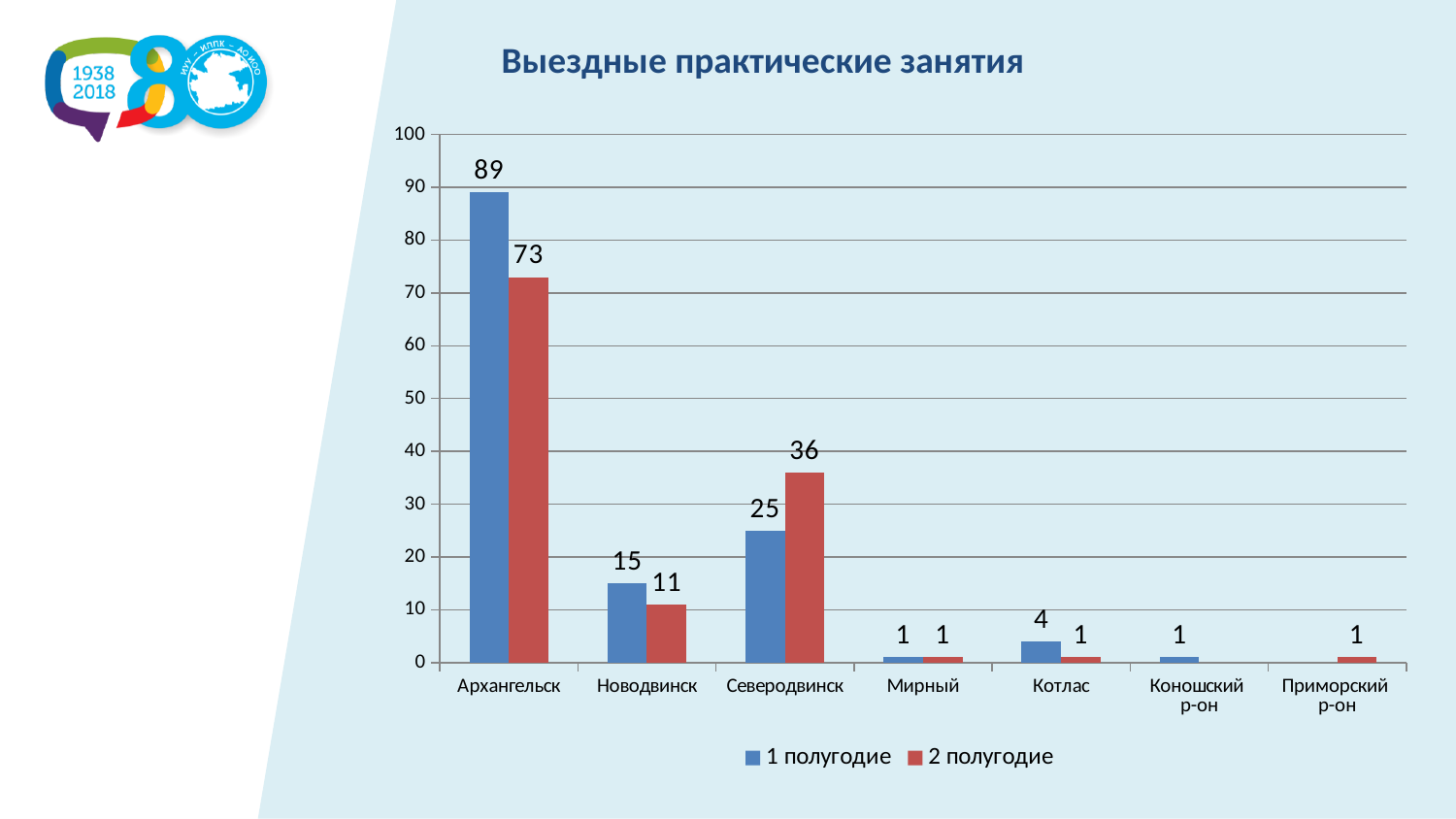
Which category has the highest value in the 2 полугодие series? Архангельск What is the value for Новодвинск in the 2 полугодие series? 11 What is the title of the chart? Выездные практические занятия Which is larger for Новодвинск: the 1 полугодие value or the 2 полугодие value? 1 полугодие What is the value for Котлас in the 1 полугодие series? 4 What is the value for Архангельск in the 1 полугодие series? 89 How many series does the legend list? 2 What kind of chart is shown on the slide? bar chart What is the difference between the 1 полугодие and 2 полугодие values for Архангельск? 16 What is the value for Северодвинск in the 2 полугодие series? 36 What is the difference between the 2 полугодие and 1 полугодие values for Северодвинск? 11 How many categories are shown on the x axis? 7